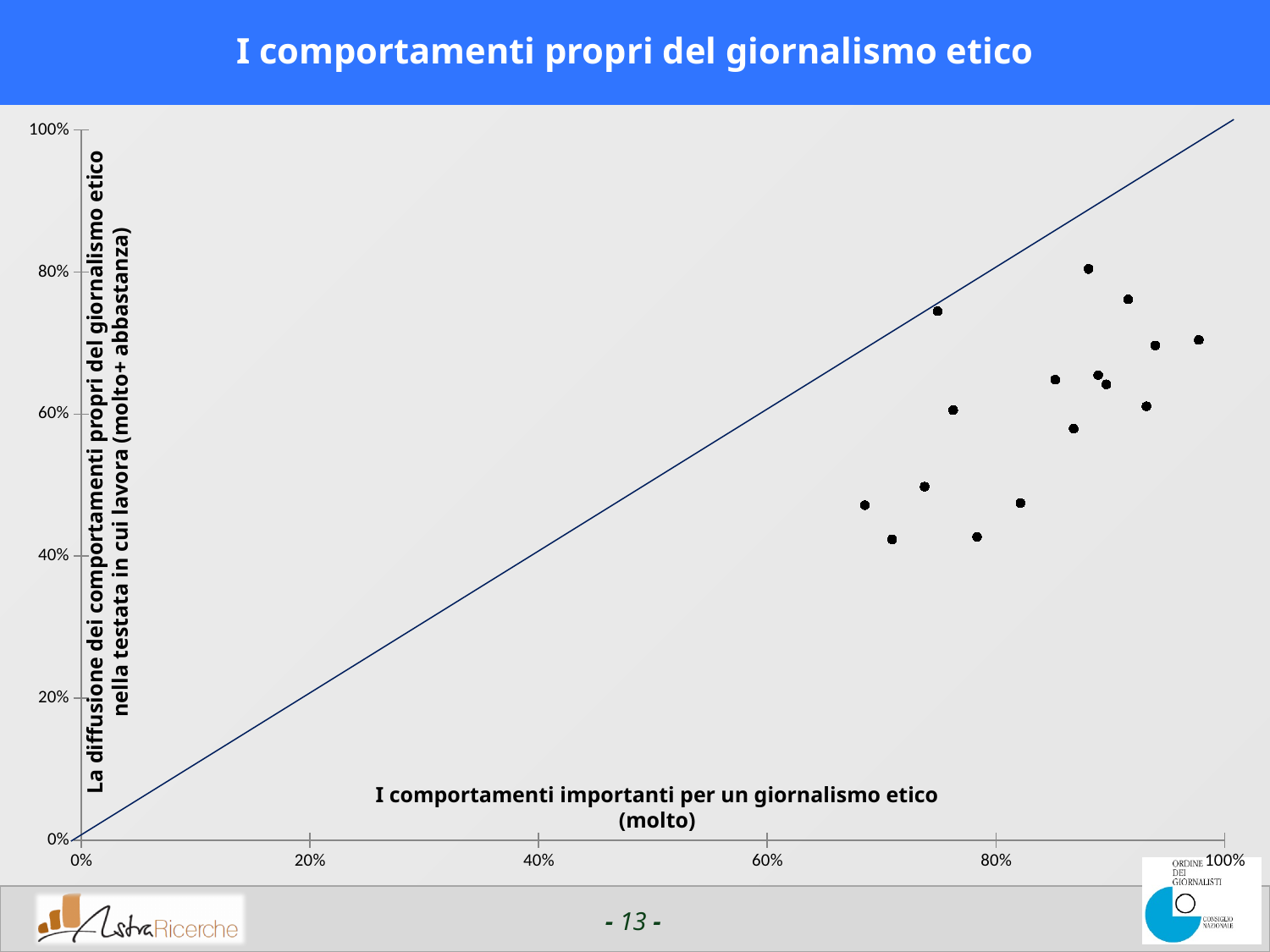
What is the label of the x axis? I comportamenti importanti per un giornalismo etico (molto) Is the x value of the rightmost plotted point greater or less than 80%? greater Is the y value of the lowest plotted point greater or less than 60%? less What is the title of the chart? I comportamenti propri del giornalismo etico Do the plotted points lie above or below the diagonal line? below How many data points are plotted on the chart? 16 Is the x value of the leftmost plotted point greater or less than 60%? greater What is the maximum value shown on the y axis? 100% What kind of chart is shown on the slide? scatter plot